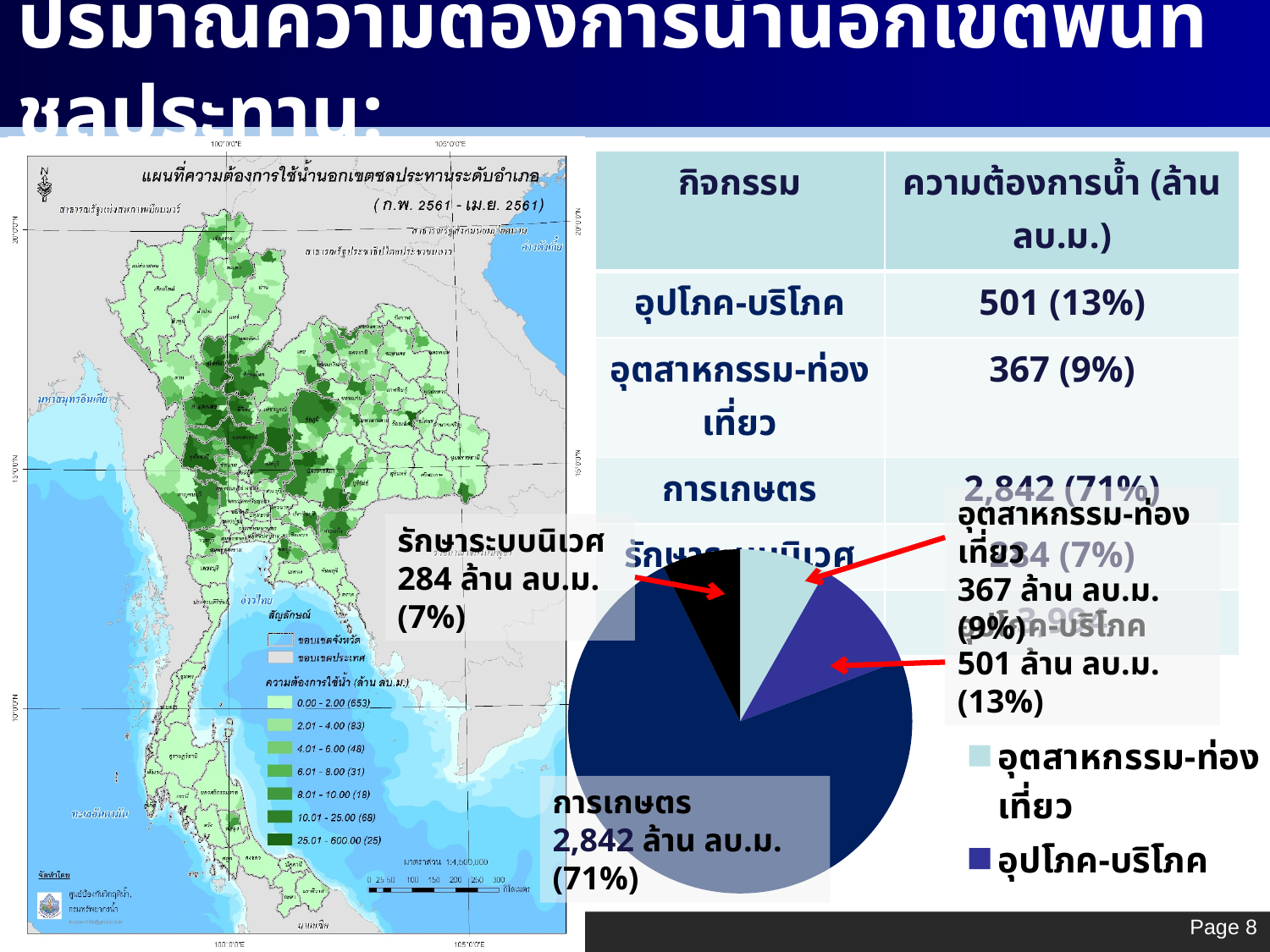
In the pie chart, which is larger: อุปโภค-บริโภค or อุตสาหกรรม-ท่องเที่ยว? อุปโภค-บริโภค What share of the pie does อุปโภค-บริโภค represent? 13% Which slice of the pie chart is the smallest? รักษาระบบนิเวศ What kind of chart is shown on the slide? pie chart In the pie chart, what is the value for อุปโภค-บริโภค? 501 ล้าน ลบ.ม. In the pie chart, what is the difference between the values for การเกษตร and อุปโภค-บริโภค? 2,341 What share of the pie does การเกษตร represent? 71% In the pie chart, what is the value for อุตสาหกรรม-ท่องเที่ยว? 367 ล้าน ลบ.ม. Which slice of the pie chart is the largest? การเกษตร In the pie chart, what is the value for รักษาระบบนิเวศ? 284 ล้าน ลบ.ม. How many slices does the pie chart have? 4 In the pie chart, what is the value for การเกษตร? 2,842 ล้าน ลบ.ม.